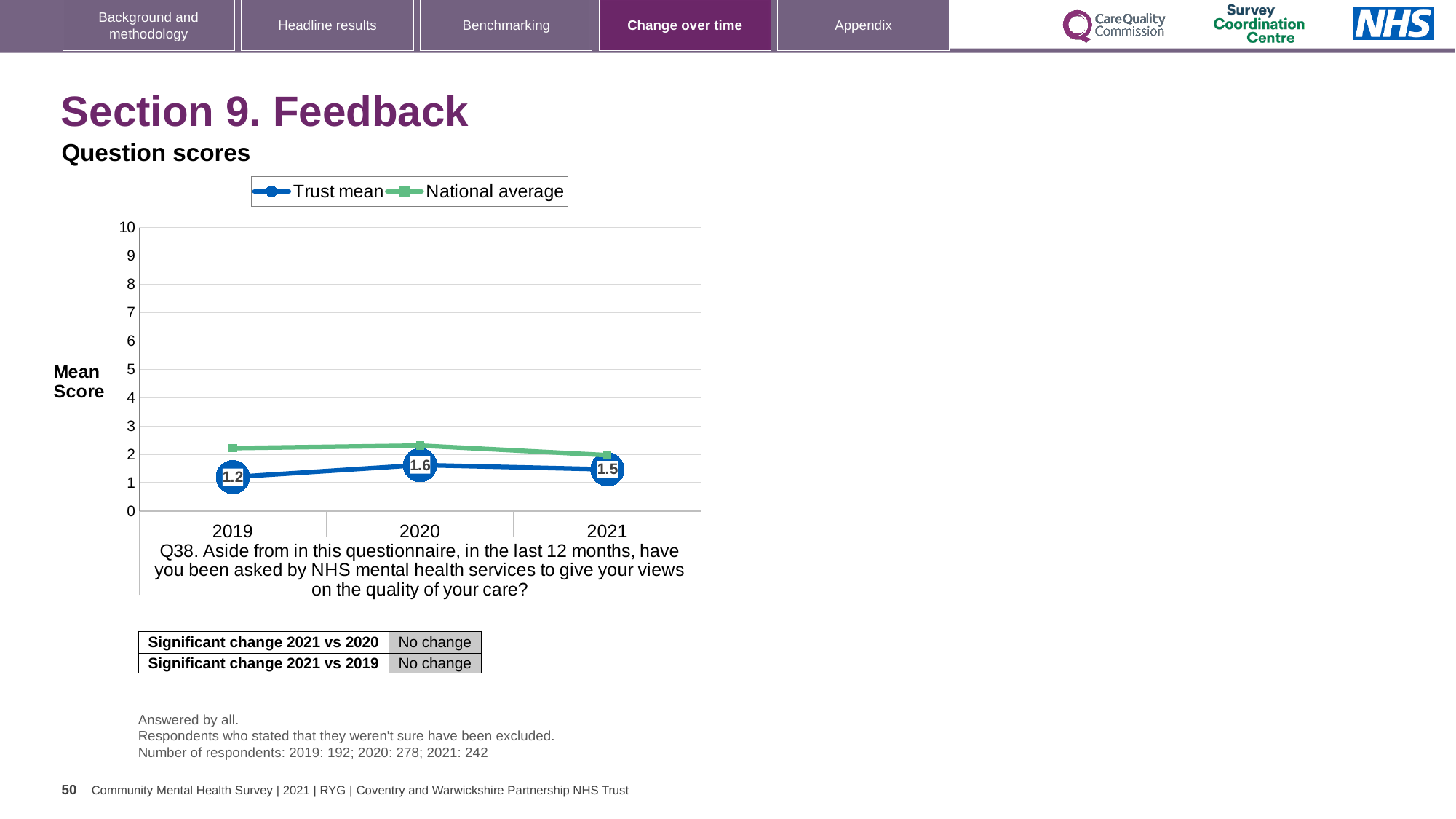
What is the Trust mean score for 2020? 1.6 What kind of chart is shown on the slide? Line chart Is the National average value for 2020 greater or less than 2? greater How many series does the legend list? 2 Which is larger, the Trust mean score in 2021 or in 2019? 2021 In which year is the Trust mean score lowest? 2019 How many years are plotted on the x axis? 3 What is the Trust mean score for 2021? 1.5 In which year is the Trust mean score highest? 2020 What is the difference between the Trust mean score in 2020 and in 2019? 0.4 What is the Trust mean score for 2019? 1.2 Does the Trust mean rise or fall from 2019 to 2020? Rise